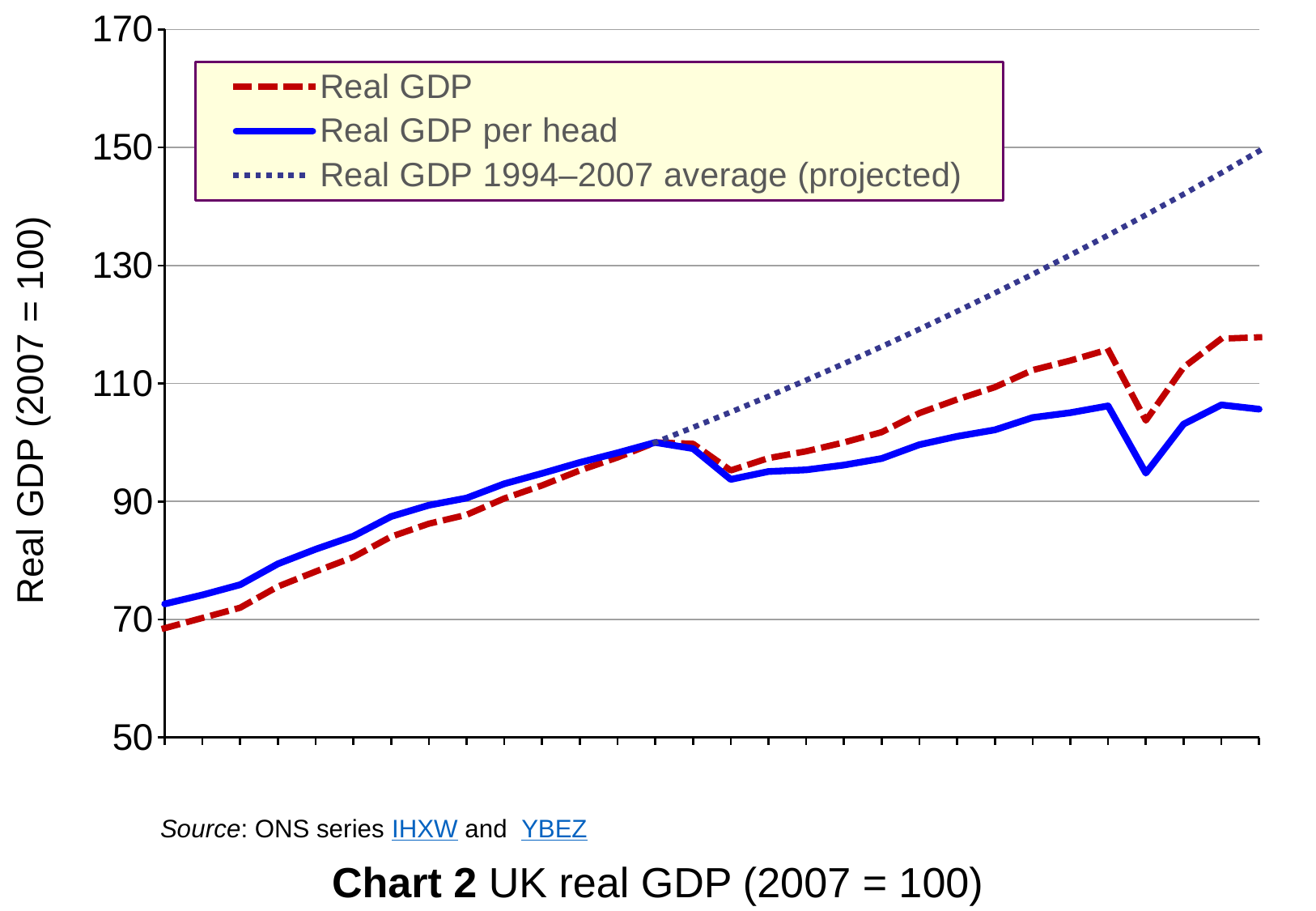
Is the first value of the Real GDP series greater or less than 70? less Is the final value of the Real GDP series greater or less than 110? greater At the right-hand end of the chart, which is larger: Real GDP or Real GDP per head? Real GDP What kind of chart is shown on the slide? line chart What is the label on the vertical axis? Real GDP (2007 = 100) How many series does the legend list? 3 What is the title of the chart? Chart 2 UK real GDP (2007 = 100) Is the final value of the Real GDP per head series greater or less than 110? less Does the Real GDP 1994–2007 average (projected) series rise or fall along the x axis? rise Which series ends at the highest value at the right-hand end of the chart? Real GDP 1994–2007 average (projected) Which series ends at the lowest value at the right-hand end of the chart? Real GDP per head